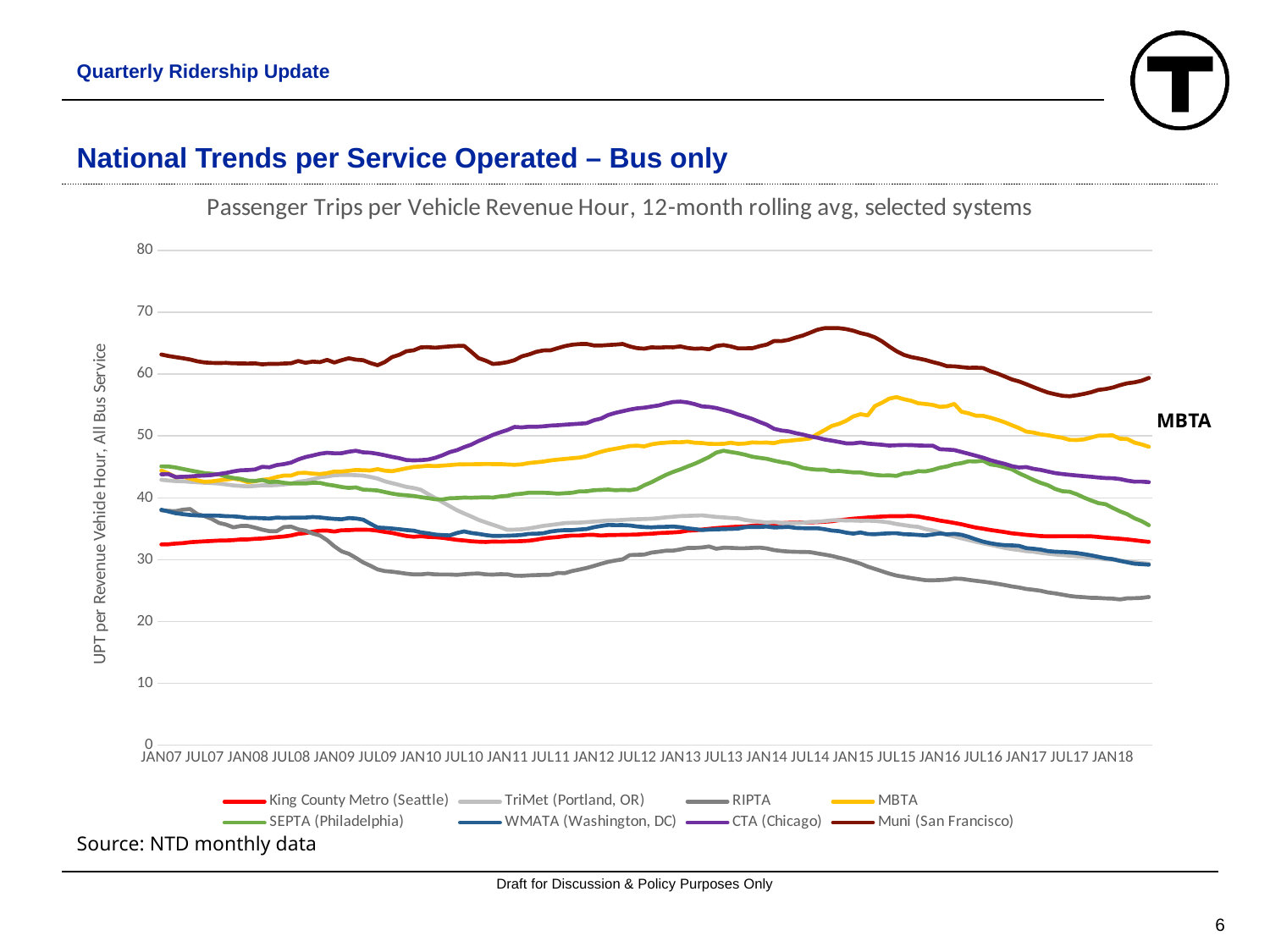
Does the Muni (San Francisco) line rise or fall from JAN15 to JUL17? Falls Does the RIPTA line rise or fall overall from JAN07 to JAN18? Falls Is the value for MBTA at JUL15 greater or less than 50? greater Is the value for RIPTA at JAN18 greater or less than 30? less Which transit system has the highest passenger trips per vehicle revenue hour across the whole period? Muni (San Francisco) What kind of chart is shown on the slide? Line chart At JAN18, which is higher: King County Metro (Seattle) or WMATA (Washington, DC)? King County Metro (Seattle) Which transit system has the lowest value at JAN18? RIPTA At JAN18, which is higher: MBTA or CTA (Chicago)? MBTA Is the value for Muni (San Francisco) at JAN18 greater or less than 50? greater How many transit systems does the legend list? 8 What is the title of the chart? Passenger Trips per Vehicle Revenue Hour, 12-month rolling avg, selected systems